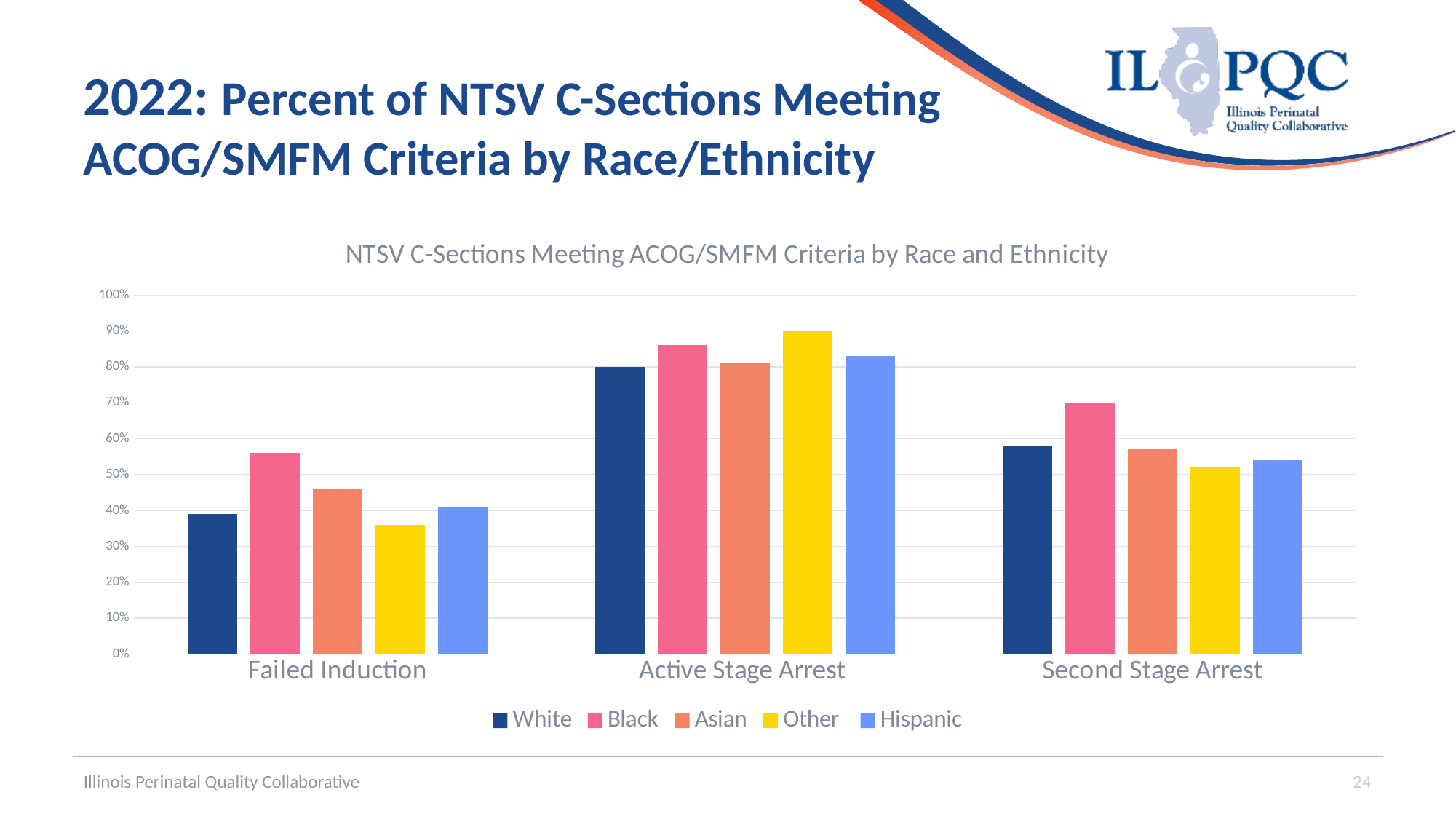
Is the value for Other in Second Stage Arrest greater or less than 60%? less Which is larger for Second Stage Arrest: the value for White or the value for Other? White Which race/ethnicity has the highest value for Active Stage Arrest? Other What type of chart is shown on the slide? bar chart What is the value for White in Active Stage Arrest? 80% Is the value for Black in Failed Induction greater or less than 50%? greater Which race/ethnicity has the lowest value for Failed Induction? Other How many categories are shown on the x axis? 3 How many series does the legend list? 5 Which race/ethnicity has the highest value for Failed Induction? Black Which race/ethnicity has the highest value for Second Stage Arrest? Black What is the title of the chart? NTSV C-Sections Meeting ACOG/SMFM Criteria by Race and Ethnicity